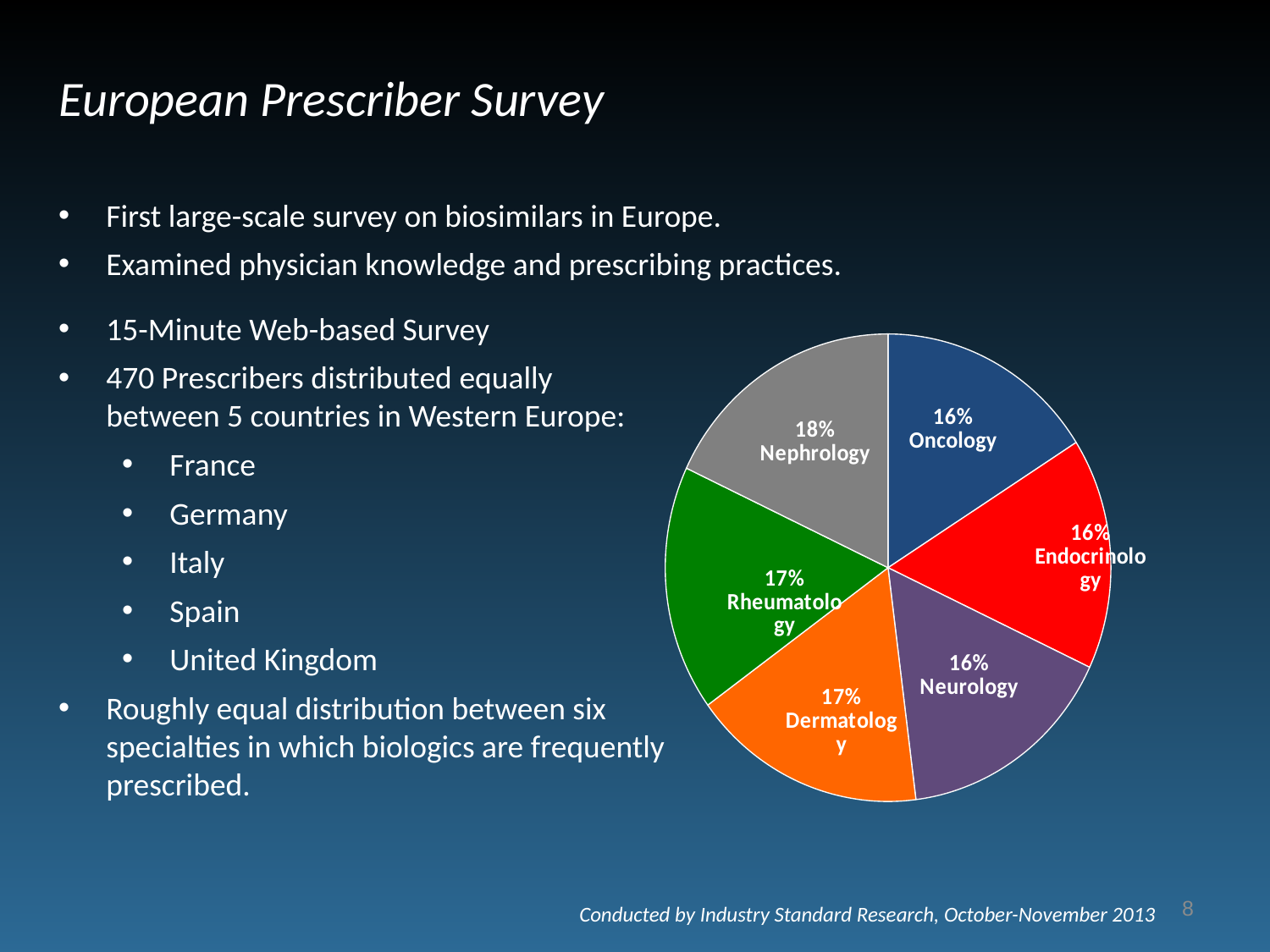
What percentage is shown for Oncology in the pie chart? 16% What percentage is shown for Neurology in the pie chart? 16% Which specialty has the largest slice in the pie chart? Nephrology What percentage is shown for Rheumatology in the pie chart? 17% What percentage is shown for Dermatology in the pie chart? 17% What is the difference in percentage points between the Nephrology slice and the Neurology slice? 2 What share of the pie chart does Nephrology represent? 18% What colour is the Nephrology slice in the pie chart? Grey What percentage is shown for Endocrinology in the pie chart? 16% How many specialties are shown in the pie chart? 6 Which is larger in the pie chart, the share for Nephrology or the share for Oncology? Nephrology What kind of chart is shown on the slide? Pie chart